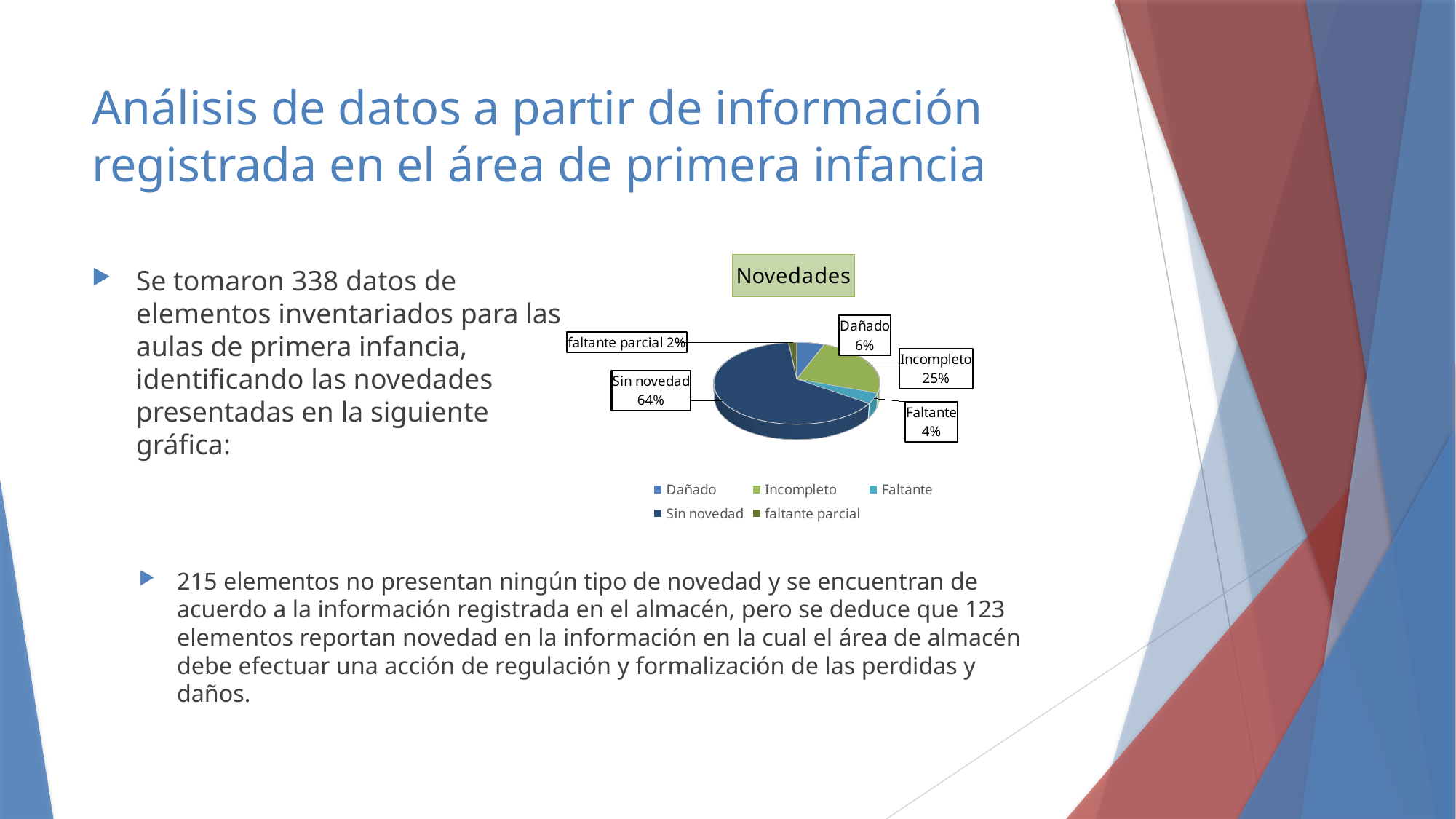
Which is larger, the share for Dañado or the share for Faltante? Dañado What percentage is shown for Faltante? 4% What percentage is shown for Incompleto? 25% Which category has the smallest slice of the pie? faltante parcial What percentage is shown for Dañado? 6% What is the title of the chart? Novedades Which category has the largest slice of the pie? Sin novedad What is the difference in percentage points between Sin novedad and Incompleto? 39 What kind of chart is shown on the slide? pie chart What share of the pie does Sin novedad represent? 64% What percentage is shown for faltante parcial? 2% How many categories does the legend list? 5